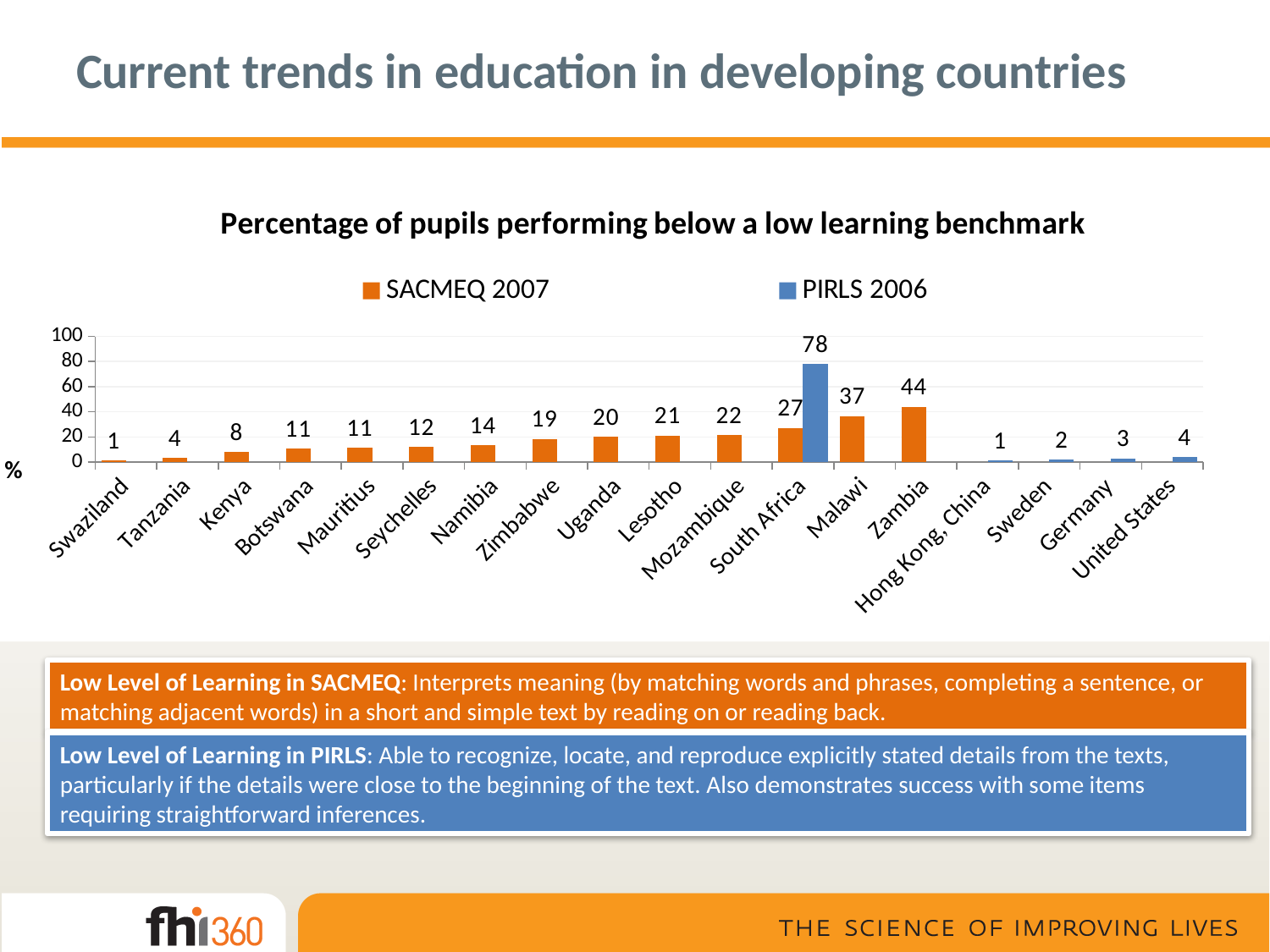
Is the PIRLS 2006 value for South Africa greater or less than 60? greater How many countries are shown on the x axis? 18 Which country has the lowest SACMEQ 2007 value? Swaziland What is the SACMEQ 2007 value for Malawi? 37 What kind of chart is shown on the slide? Bar chart Which country has the highest SACMEQ 2007 value? Zambia What is the SACMEQ 2007 value for Zambia? 44 How many series does the legend list? 2 Which is larger, the SACMEQ 2007 value for Malawi or for Mozambique? Malawi What is the difference between the PIRLS 2006 and SACMEQ 2007 values for South Africa? 51 What is the PIRLS 2006 value for Germany? 3 What is the PIRLS 2006 value for South Africa? 78